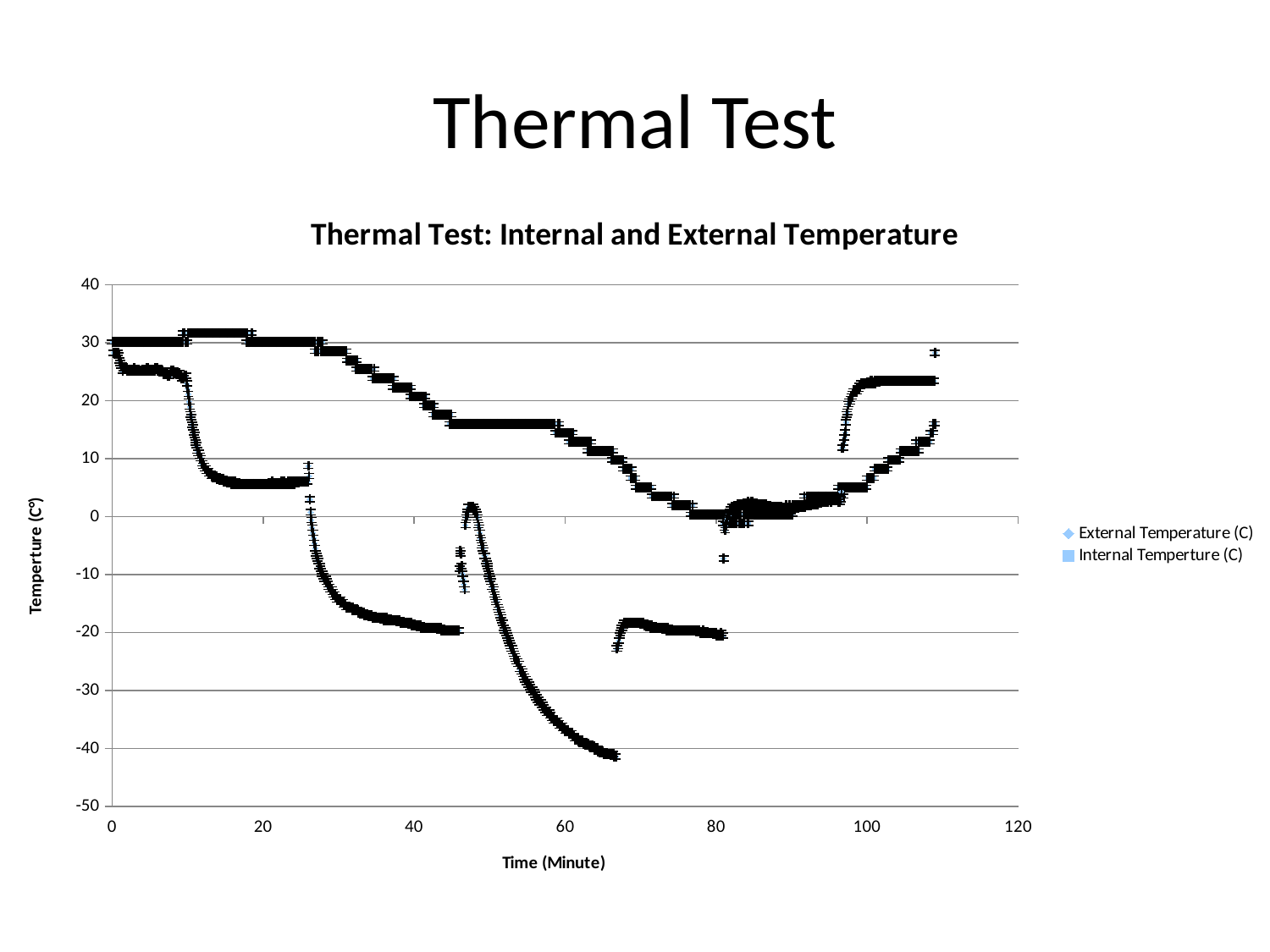
What is the title of the chart? Thermal Test: Internal and External Temperature Is the highest plotted temperature on the chart greater or less than 40? less What kind of chart is shown on the slide? scatter chart Is the lowest plotted temperature on the chart greater or less than -30? less Is the lowest plotted temperature on the chart greater or less than -50? greater What are the two series named in the legend? External Temperature (C) and Internal Temperture (C) How many series does the chart legend list? 2